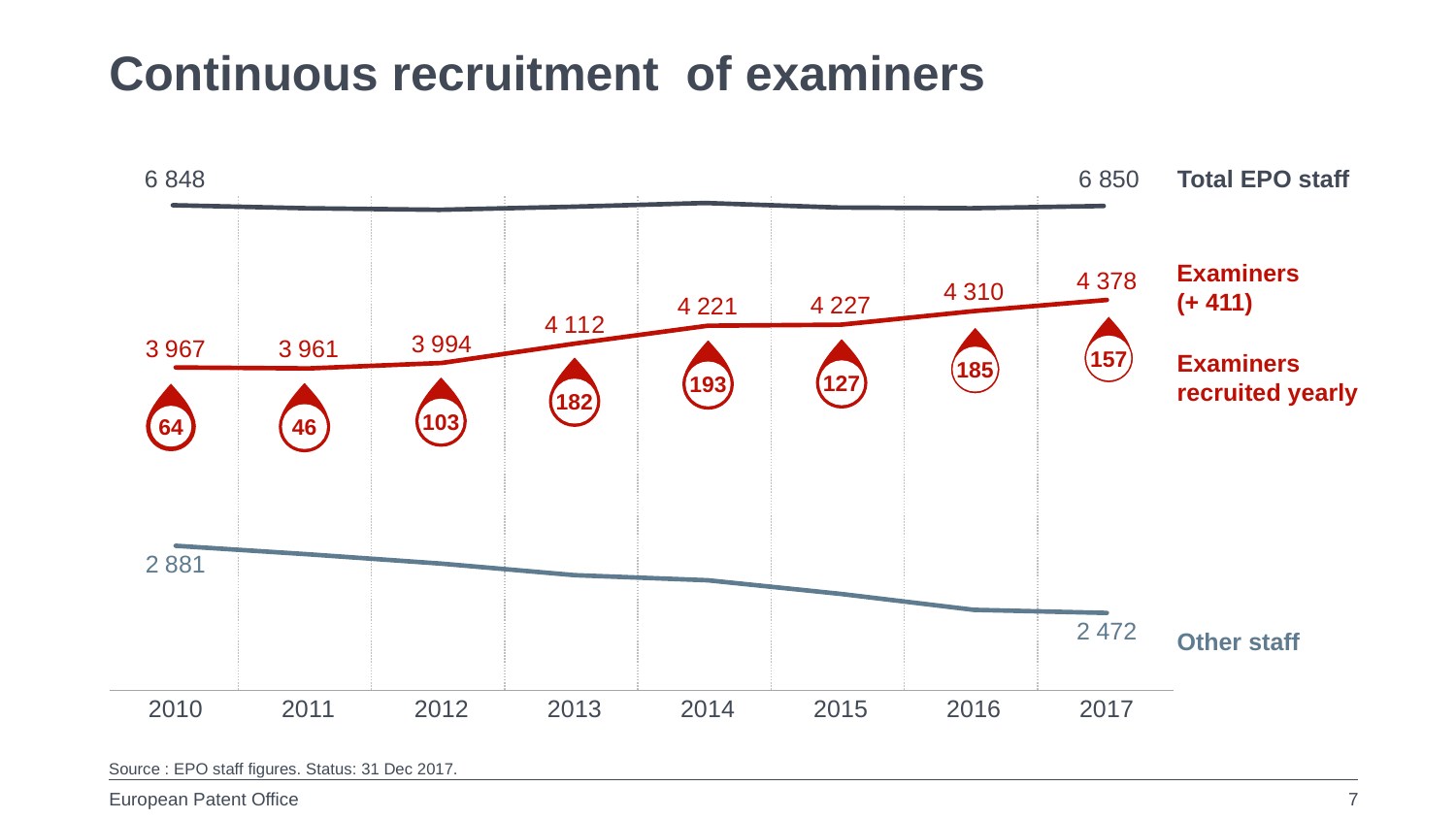
What kind of chart is shown on the slide? Line chart In which year were the fewest examiners recruited? 2011 Which year had more examiners recruited, 2013 or 2015? 2013 What was the total EPO staff in 2010? 6 848 How many examiners were recruited in 2014? 193 How many years are shown on the x axis? 8 What is the difference between Other staff in 2010 and in 2017? 409 In which year were the most examiners recruited? 2014 Does the Other staff line rise or fall from 2010 to 2017? Fall By how much did the number of examiners increase from 2010 to 2017? 411 What is the number of examiners in 2017? 4 378 What is the value for Other staff in 2017? 2 472